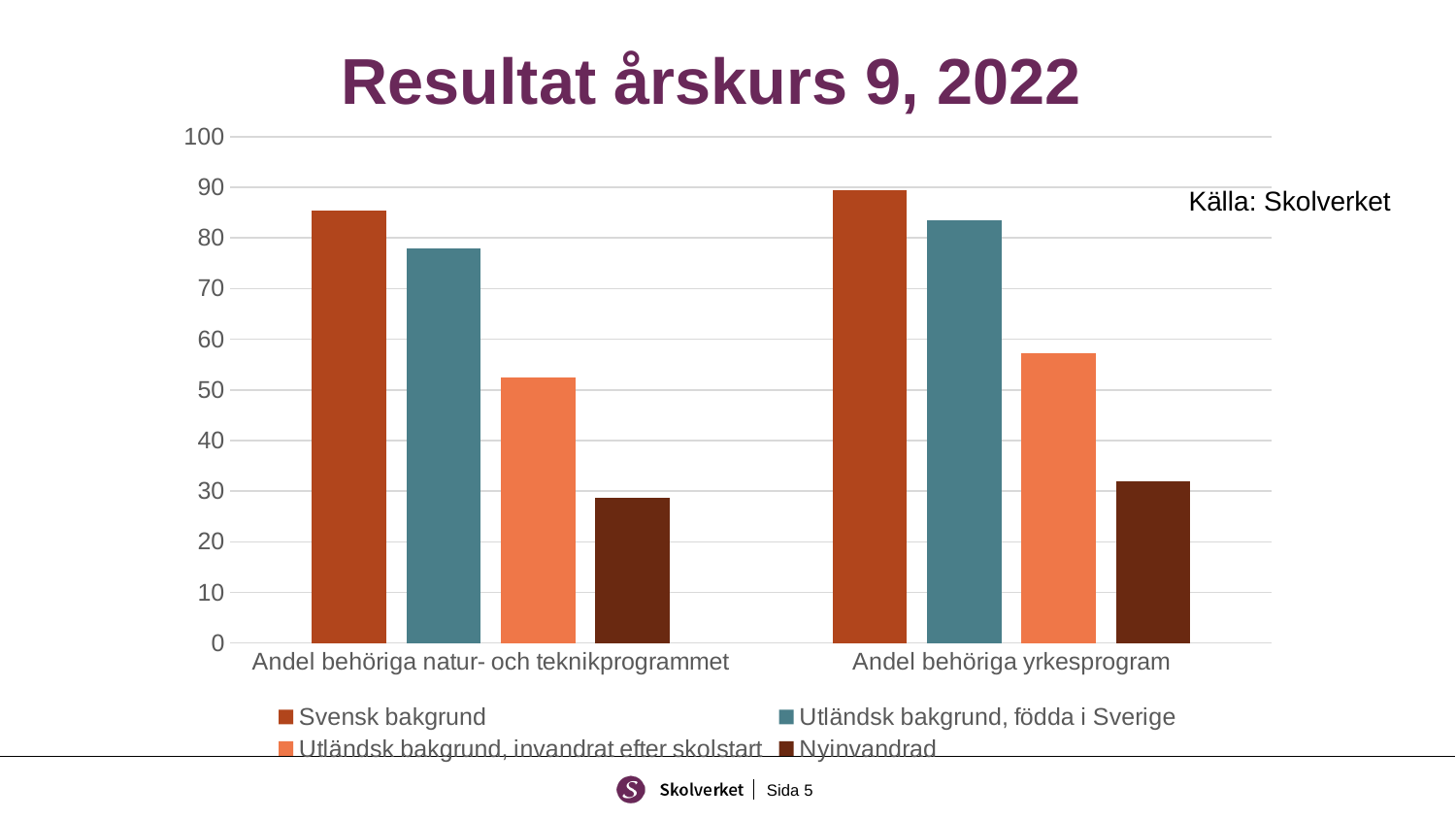
How many categories are shown on the x axis? 2 Is the value for 'Nyinvandrad' in 'Andel behöriga natur- och teknikprogrammet' greater or less than 30? less Is the value for 'Svensk bakgrund' in 'Andel behöriga natur- och teknikprogrammet' greater or less than 80? greater What kind of chart is shown on the slide? Bar chart Is the value for 'Utländsk bakgrund, invandrat efter skolstart' in 'Andel behöriga yrkesprogram' greater or less than 50? greater Which is larger: 'Svensk bakgrund' for 'Andel behöriga natur- och teknikprogrammet' or 'Svensk bakgrund' for 'Andel behöriga yrkesprogram'? Andel behöriga yrkesprogram Which series has the lowest value for 'Andel behöriga natur- och teknikprogrammet'? Nyinvandrad How many series does the legend list? 4 Which is larger for 'Andel behöriga yrkesprogram': 'Utländsk bakgrund, födda i Sverige' or 'Utländsk bakgrund, invandrat efter skolstart'? Utländsk bakgrund, födda i Sverige What is the title of the chart? Resultat årskurs 9, 2022 Which series has the highest value for 'Andel behöriga yrkesprogram'? Svensk bakgrund What source is cited for the chart? Skolverket